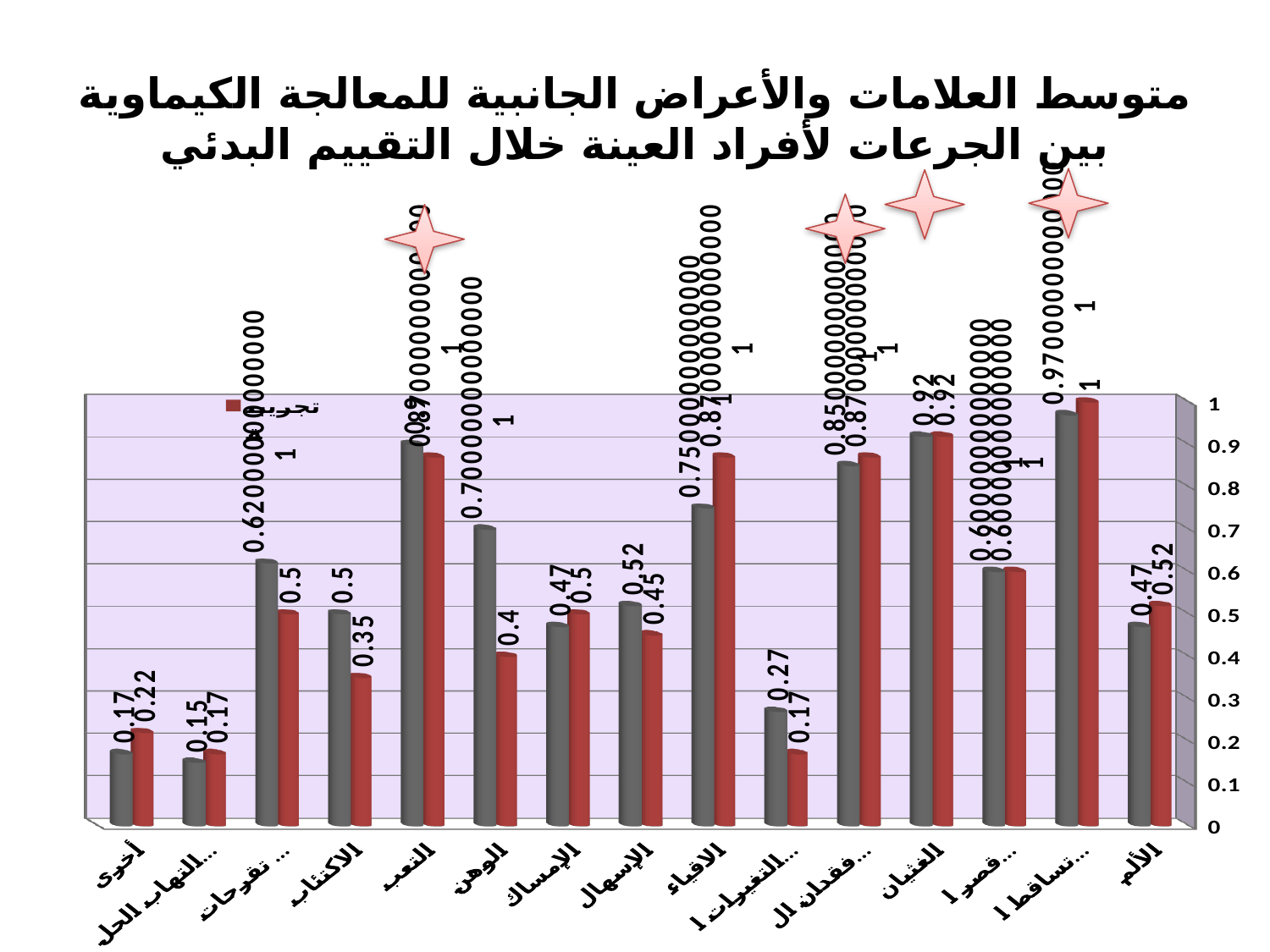
Which category has the highest red (تجريبي) bar? تساقط ا... For الإسهال, which bar is larger, the grey bar or the red (تجريبي) bar? the grey bar What is the difference between the grey and red bars for الوهن? 0.3 Is the grey bar for الغثيان greater or less than 0.9? greater How many categories are shown along the x axis of the chart? 15 What is the value of the red (تجريبي) bar for الألم? 0.52 What is the value of the red (تجريبي) bar for الاكتئاب? 0.35 What is the value of the red (تجريبي) bar for الوهن? 0.4 How many series are plotted in the chart? 2 What is the value of the grey bar for الاقياء? 0.75 What kind of chart is shown on the slide? bar chart What is the value of the grey bar for الوهن? 0.7